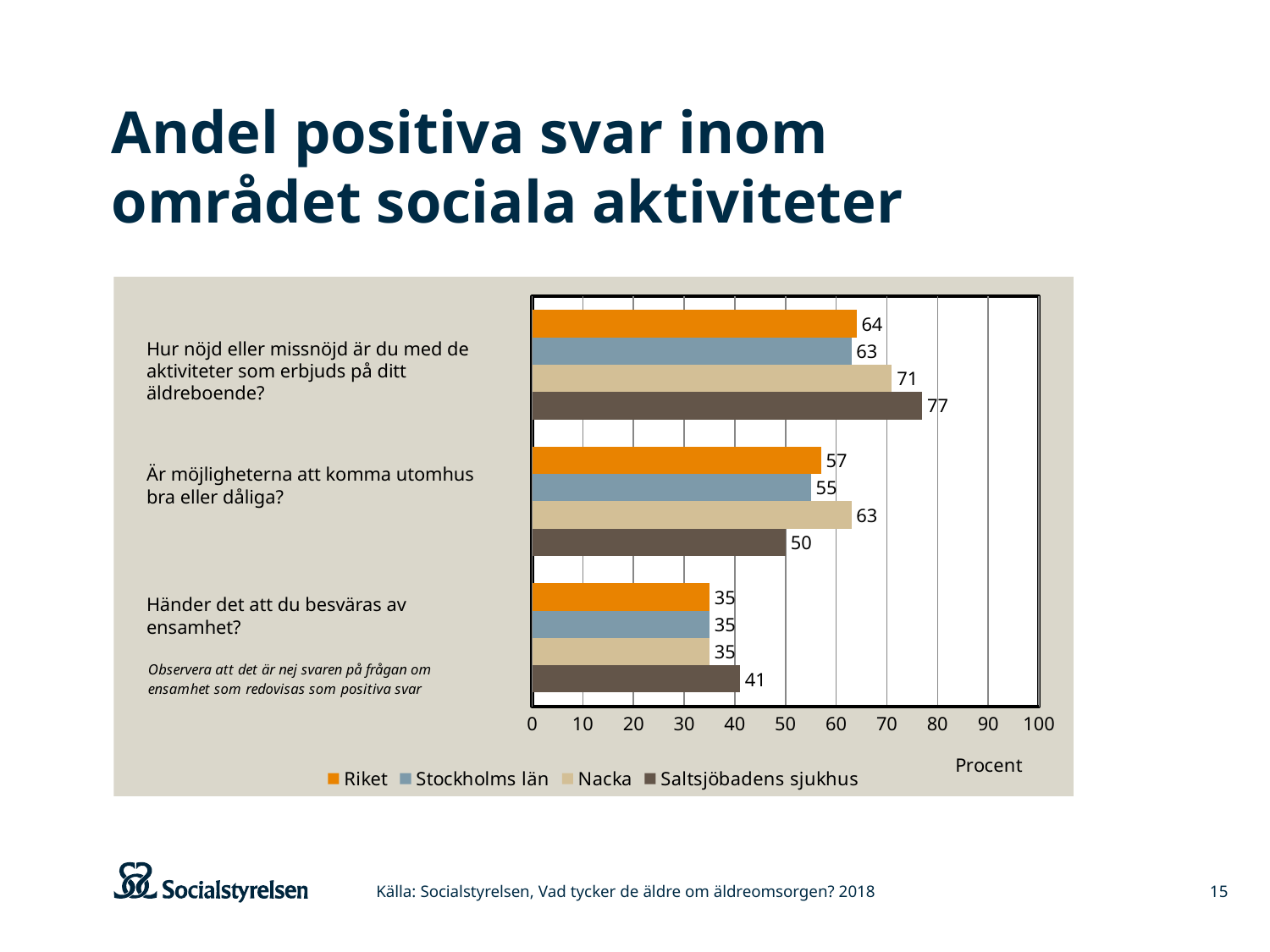
How many series does the legend list? 4 Which is larger on the question "Är möjligheterna att komma utomhus bra eller dåliga?": Riket or Nacka? Nacka What is the difference between Saltsjöbadens sjukhus and Riket on the question "Hur nöjd eller missnöjd är du med de aktiviteter som erbjuds på ditt äldreboende?"? 13 What kind of chart is shown on the slide? Bar chart What is the value for Riket on the question "Händer det att du besväras av ensamhet?"? 35 What is the value for Nacka on the question "Är möjligheterna att komma utomhus bra eller dåliga?"? 63 What is the label on the horizontal axis of the chart? Procent What is the difference between Saltsjöbadens sjukhus and Nacka on the question "Händer det att du besväras av ensamhet?"? 6 Which series has the lowest value on the question "Är möjligheterna att komma utomhus bra eller dåliga?"? Saltsjöbadens sjukhus What is the value for Saltsjöbadens sjukhus on the question "Hur nöjd eller missnöjd är du med de aktiviteter som erbjuds på ditt äldreboende?"? 77 Which series has the highest value on the question "Hur nöjd eller missnöjd är du med de aktiviteter som erbjuds på ditt äldreboende?"? Saltsjöbadens sjukhus How many questions (categories) are shown on the chart? 3